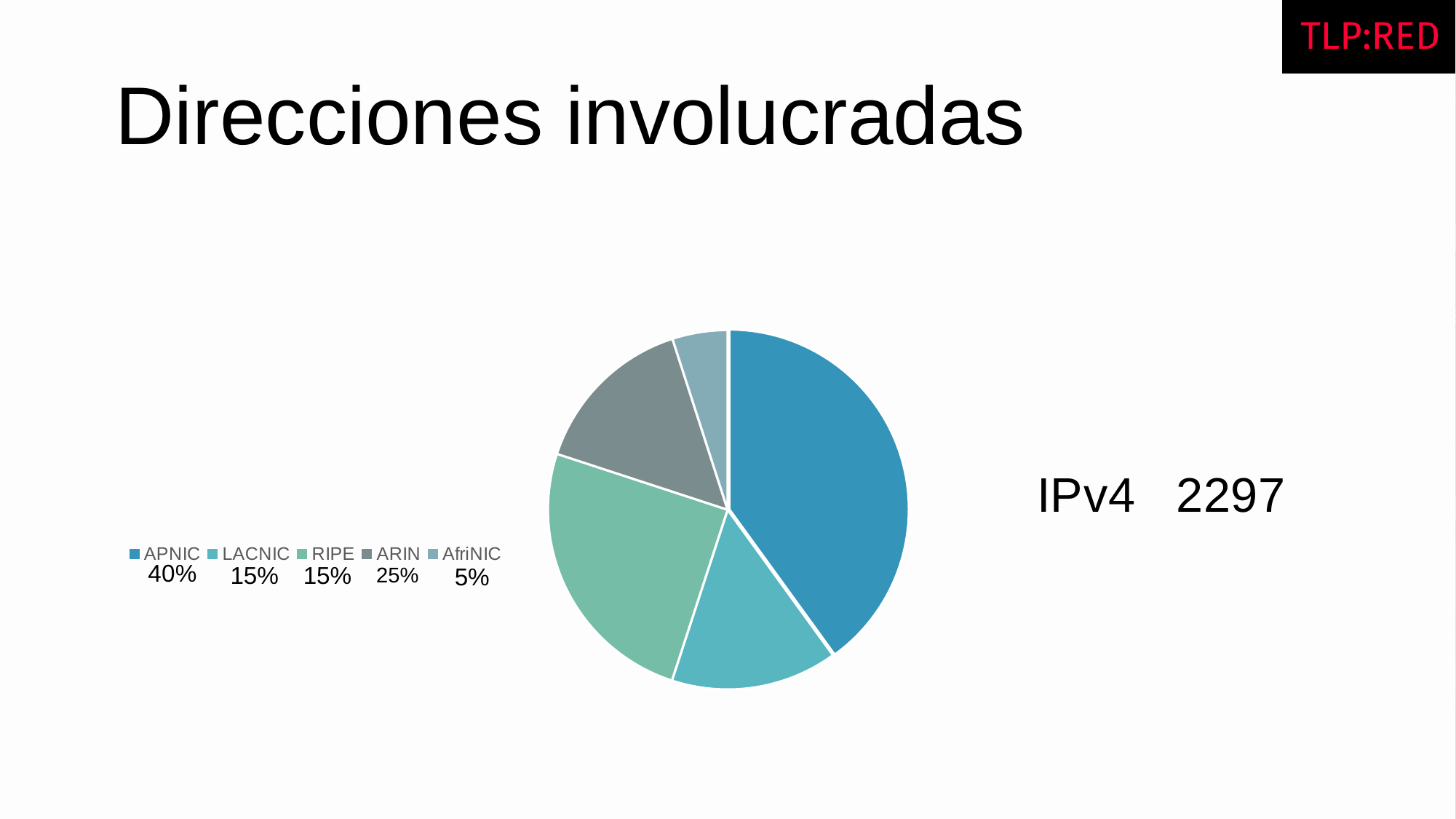
What share of the pie does APNIC represent? 40% How many slices does the pie chart have? 5 Which category has the smallest slice of the pie? AfriNIC What share of the pie does AfriNIC represent? 5% What is the value shown for LACNIC? 15% What kind of chart is shown on the slide? pie chart What is the title of the slide containing the pie chart? Direcciones involucradas Which category has the largest slice of the pie? APNIC